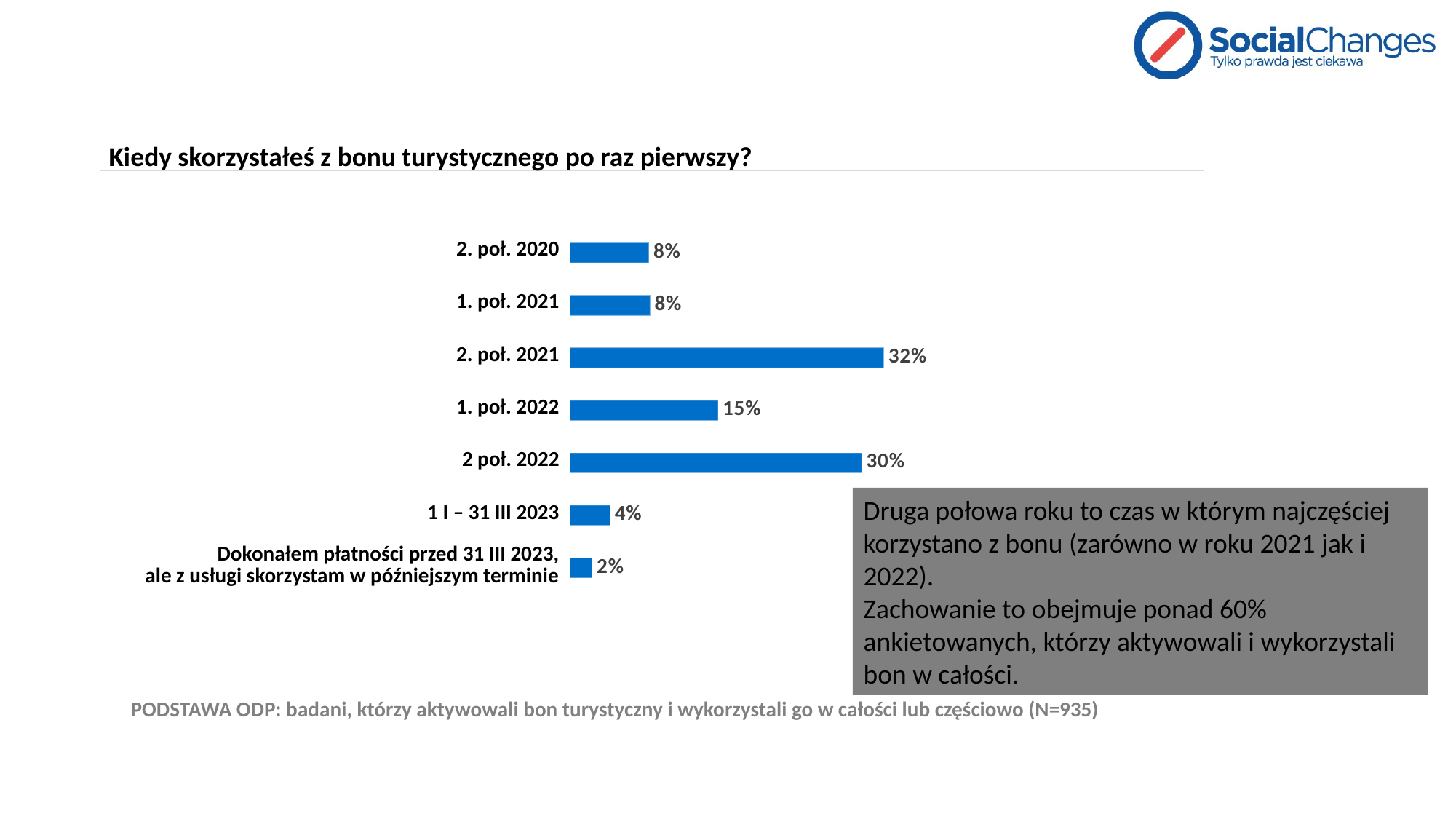
What kind of chart is shown on the slide? Bar chart Which category has the lowest value? Dokonałem płatności przed 31 III 2023, ale z usługi skorzystam w późniejszym terminie What is the difference between the values for 1. poł. 2022 and 2. poł. 2020? 7 percentage points What is the value for 1. poł. 2022? 15% What is the value for 2 poł. 2022? 30% What is the value for 2. poł. 2021? 32% Which category has the highest value? 2. poł. 2021 What is the difference between the values for 2. poł. 2021 and 2 poł. 2022? 2 percentage points What is the title of the chart? Kiedy skorzystałeś z bonu turystycznego po raz pierwszy? How many categories does the chart show? 7 Which is larger, the value for 1. poł. 2022 or the value for 1 I – 31 III 2023? 1. poł. 2022 What is the value for 1 I – 31 III 2023? 4%